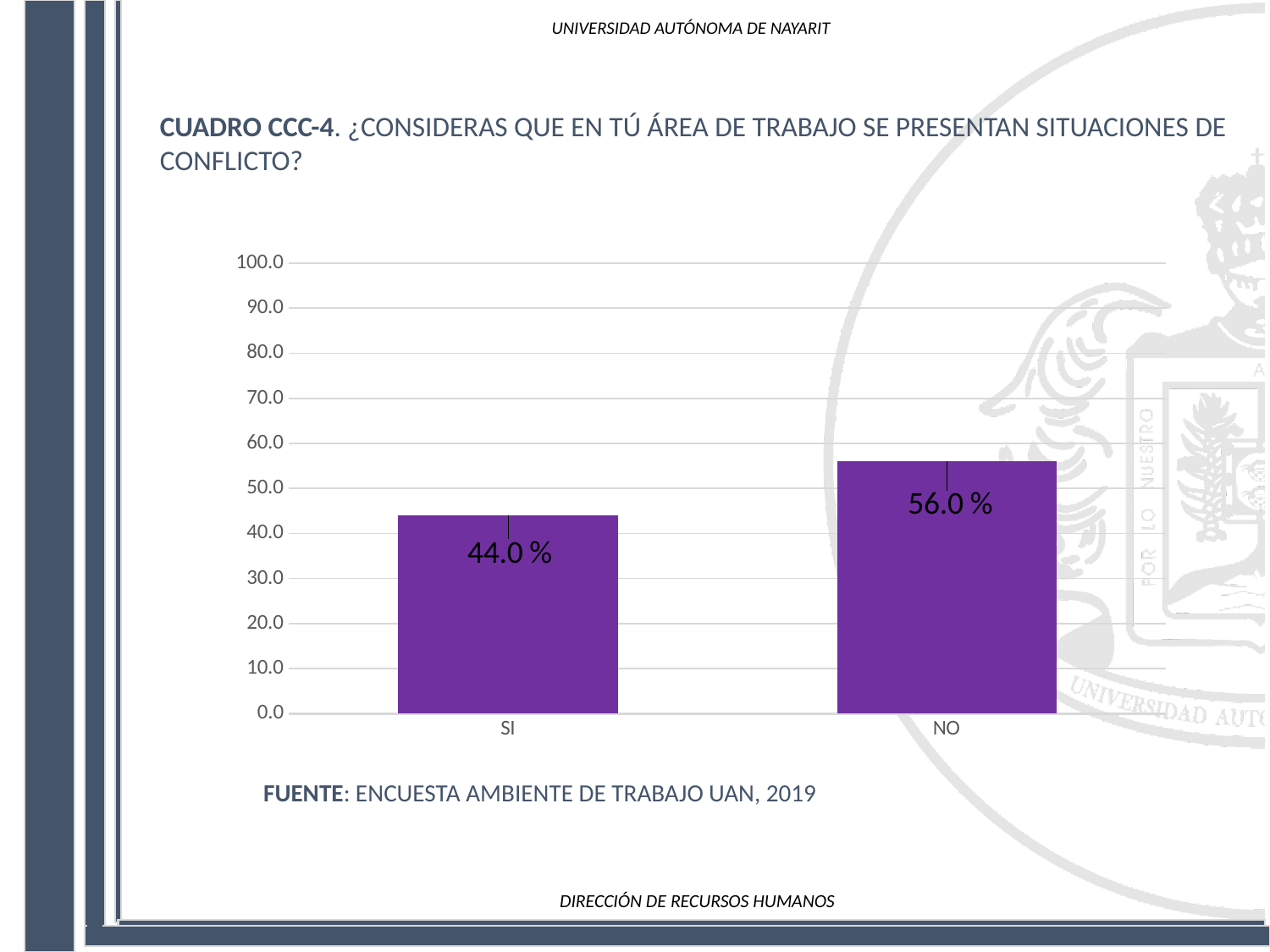
Which category has the highest value? NO How many categories are shown on the x axis? 2 Which is larger, the value for SI or the value for NO? NO What is the value for NO? 56.0 % What is the total of the values for SI and NO? 100.0 % What kind of chart is shown on the slide? bar chart Which category has the lowest value? SI What is the value for SI? 44.0 % Is the value for SI greater or less than 50.0? less What is the difference between the values for NO and SI? 12.0 % Is the value for NO greater or less than 50.0? greater What is the source cited below the chart? ENCUESTA AMBIENTE DE TRABAJO UAN, 2019